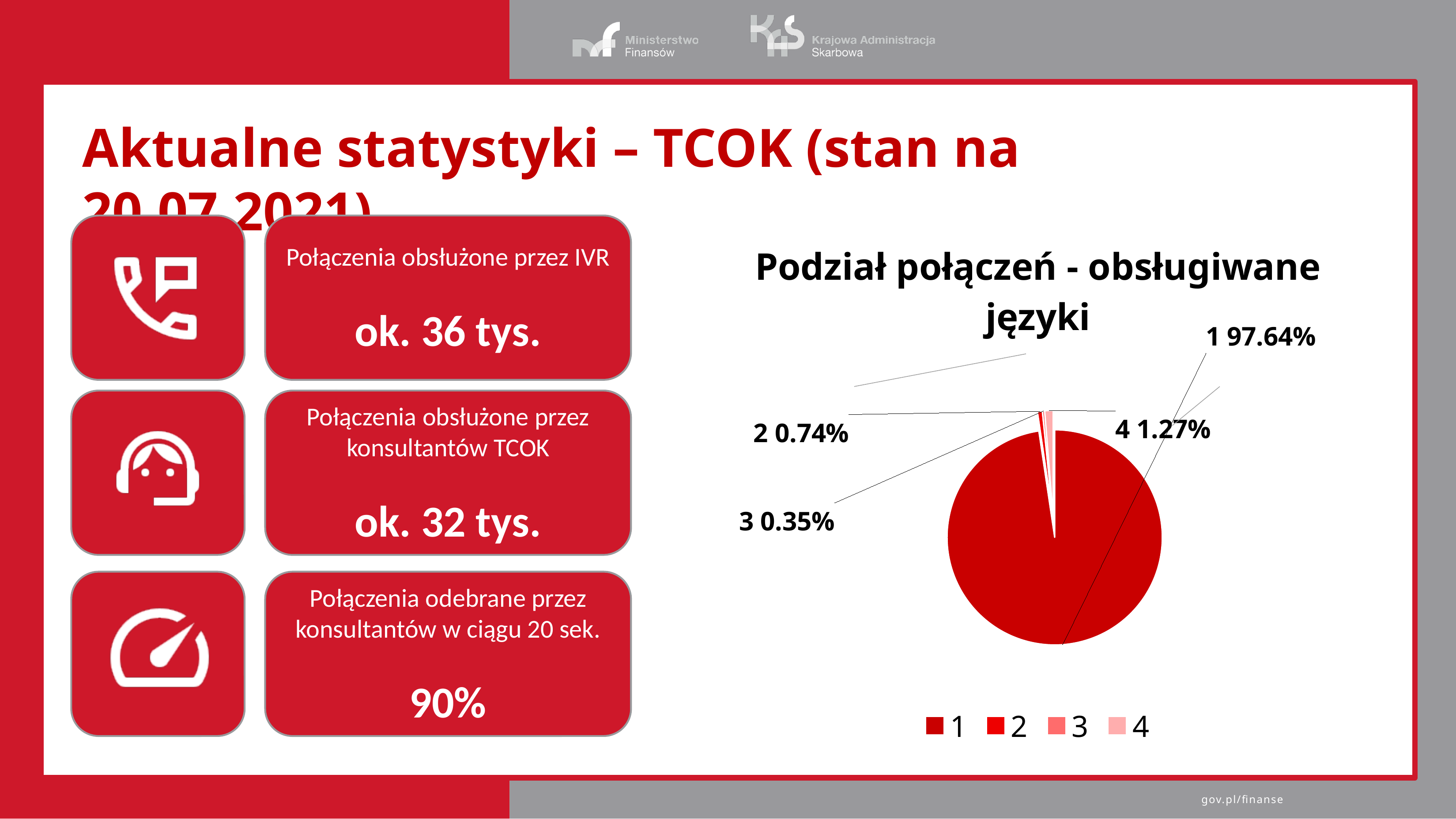
What share of the pie does category 1 have? 97.64% What share of the pie does category 2 have? 0.74% How many categories does the legend list? 4 What share of the pie does category 3 have? 0.35% Which category has the smallest slice of the pie? 3 Which has a larger share, category 2 or category 4? 4 Which category has the largest slice of the pie? 1 What is the difference in percentage points between category 4 and category 2? 0.53% What is the difference in percentage points between category 1 and category 4? 96.37% What is the title of the chart? Podział połączeń - obsługiwane języki What share of the pie does category 4 have? 1.27% What type of chart is shown on the slide? pie chart